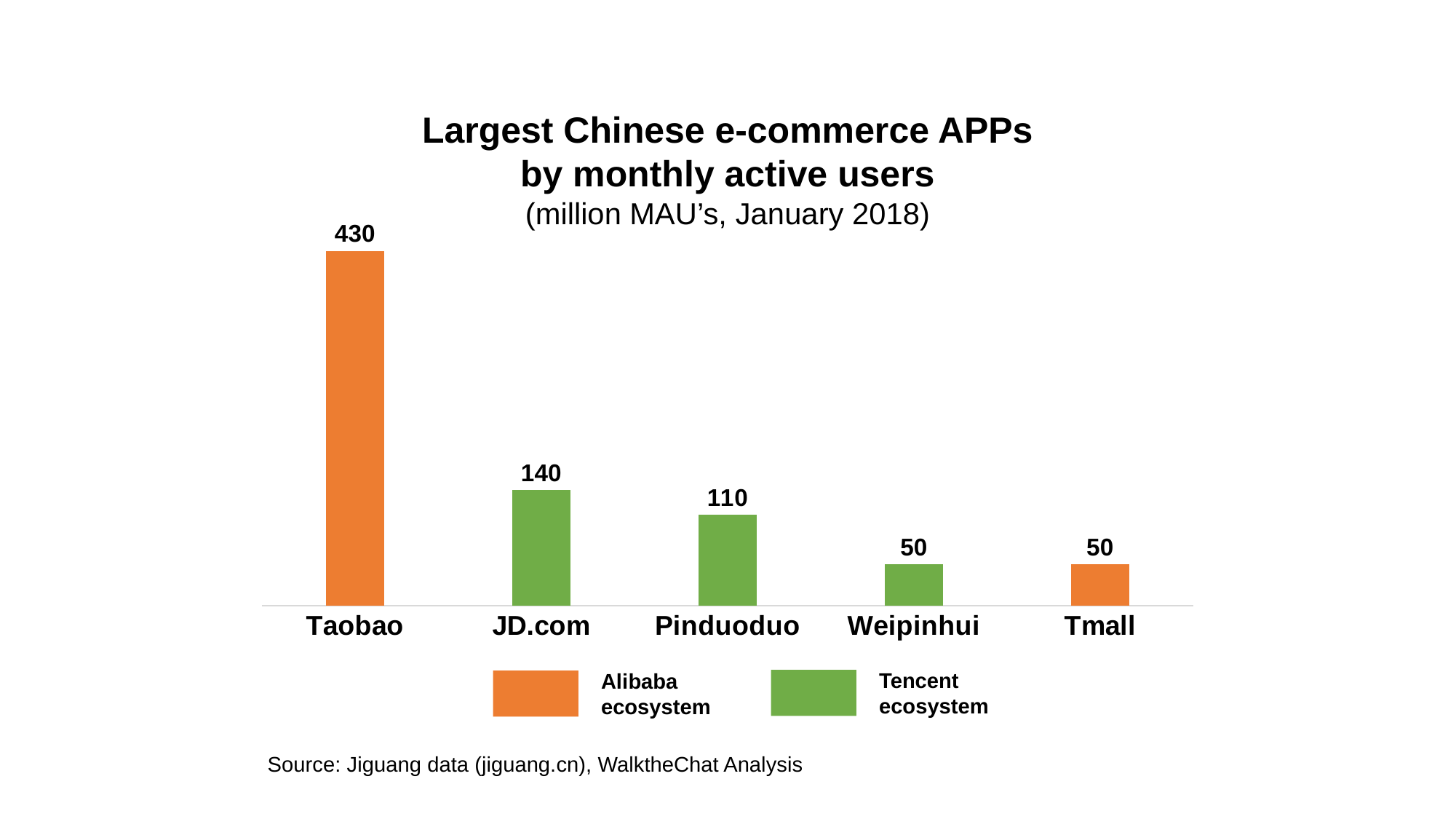
How many series does the legend list? 2 What is the value for Pinduoduo? 110 What is the difference between the values for Taobao and JD.com? 290 What is the difference between the values for JD.com and Pinduoduo? 30 Which ecosystem does the legend associate with the green bars? Tencent ecosystem What kind of chart is this? Bar chart What is the value for JD.com? 140 What is the value for Weipinhui? 50 Which app has the highest monthly active users? Taobao What is the value for Taobao? 430 How many apps are shown in the chart? 5 Which is larger, the value for Pinduoduo or the value for Tmall? Pinduoduo